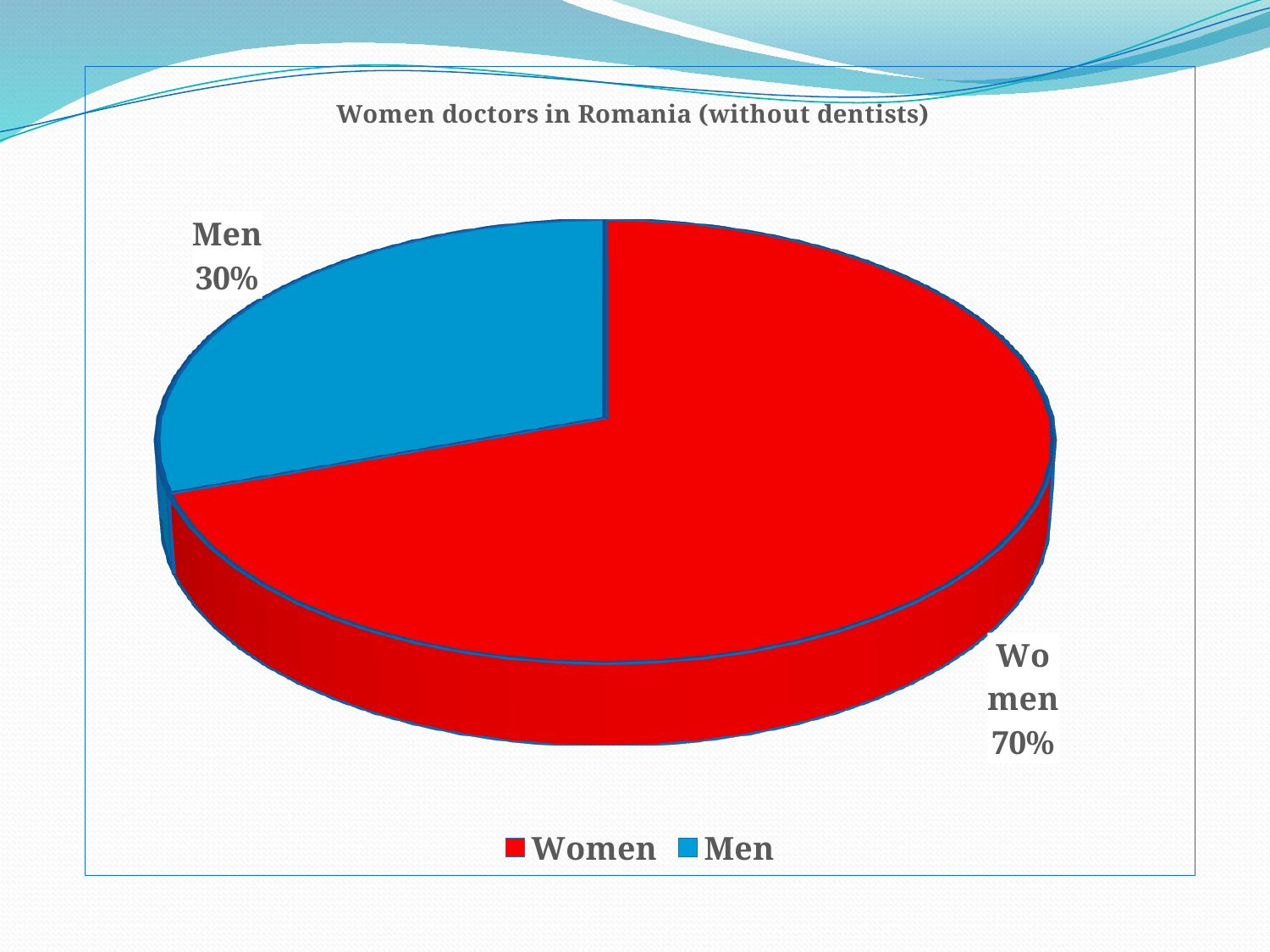
What kind of chart is shown on the slide? pie chart How many categories does the pie chart have? 2 What is the title of the chart? Women doctors in Romania (without dentists) Which category has the smallest slice? Men What is the difference in percentage points between the Women and Men slices? 40 What share of the pie is Men? 30% How many entries does the legend list? 2 Which category has the largest slice? Women What colour is the Men slice? blue What share of the pie is Women? 70% Which is larger, the Women slice or the Men slice? Women